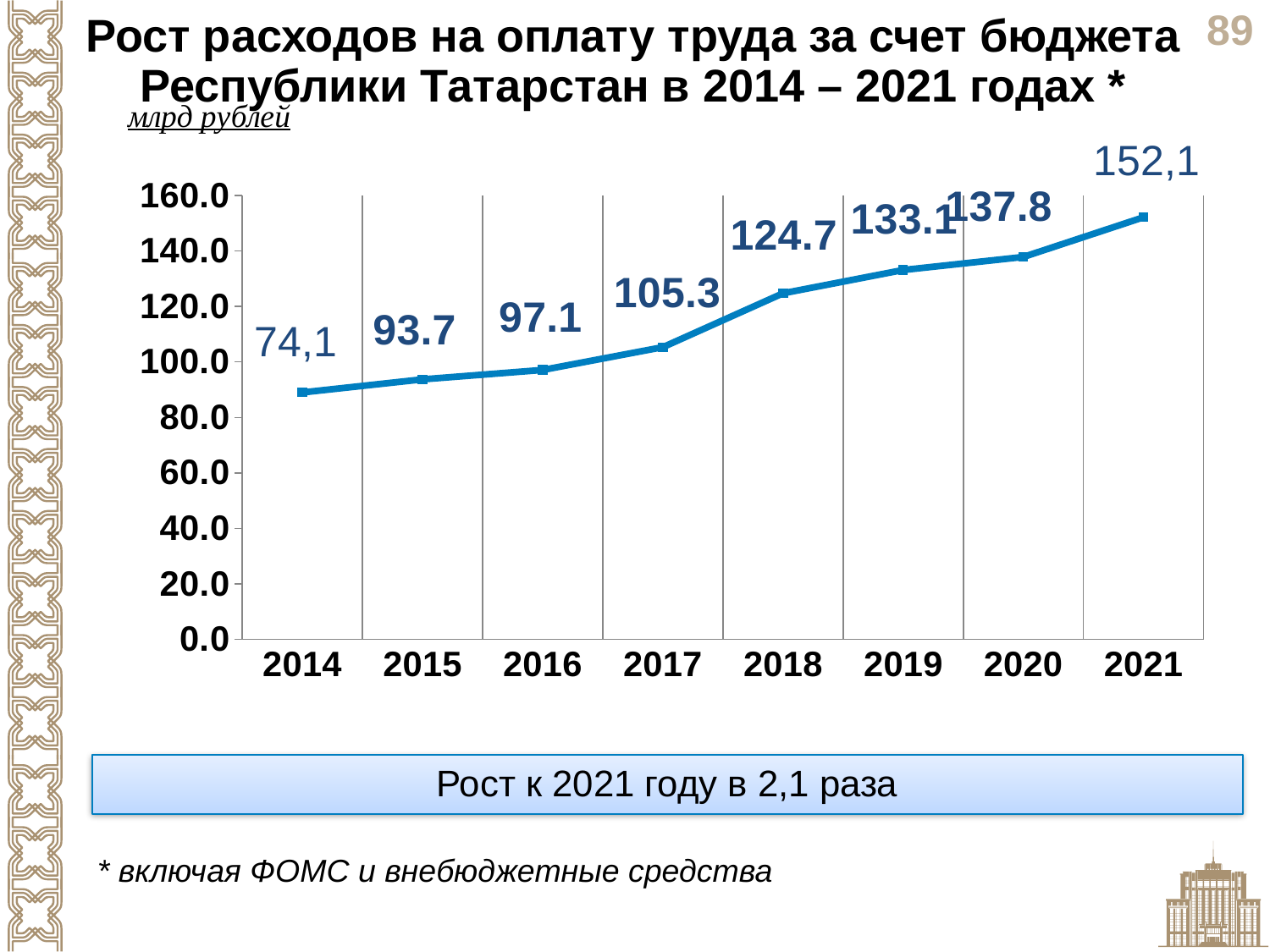
What is the difference between the values for 2019 and 2018? 8.4 What is the value for 2016? 97.1 How many years are plotted on the x axis? 8 Is the value for 2019 greater or less than 120? greater What type of chart is shown on the slide? line chart Which year has the lowest value? 2014 Which year has the highest value? 2021 What is the value for 2021? 152,1 Which is larger, the value for 2017 or the value for 2015? 2017 What is the value for 2020? 137.8 What is the value for 2018? 124.7 Do the values rise or fall from 2014 to 2021? rise